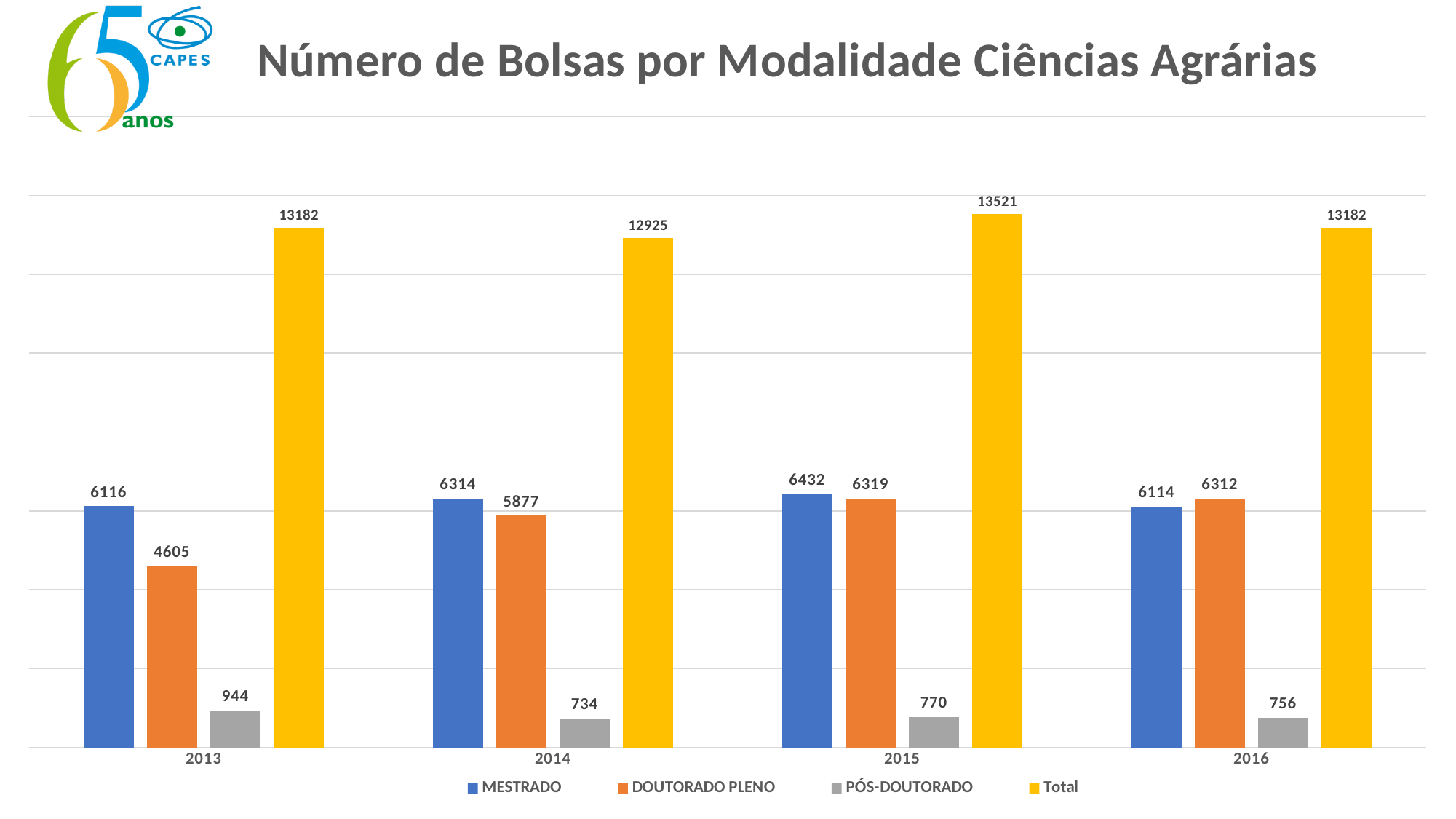
Which is larger in 2016, MESTRADO or DOUTORADO PLENO? DOUTORADO PLENO What kind of chart is shown on the slide? Bar chart In which year is the Total highest? 2015 What is the value for DOUTORADO PLENO in 2014? 5877 How many series does the legend list? 4 In which year is the PÓS-DOUTORADO value lowest? 2014 What is the difference between the MESTRADO and DOUTORADO PLENO values in 2013? 1511 What is the title of the chart? Número de Bolsas por Modalidade Ciências Agrárias How many years are shown on the x axis? 4 What is the value for PÓS-DOUTORADO in 2016? 756 What is the value for MESTRADO in 2013? 6116 What is the Total value for 2015? 13521